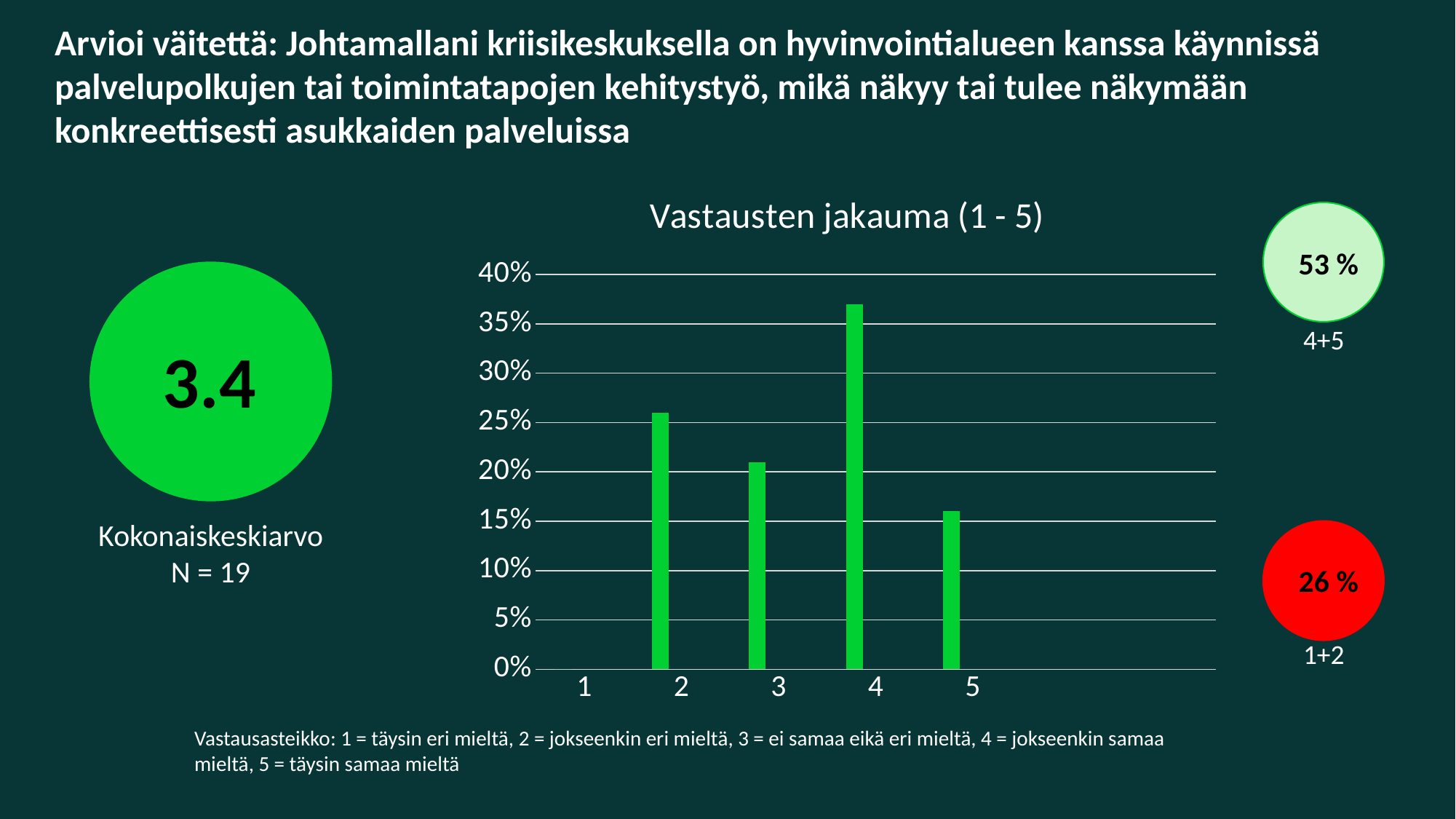
What is the title of the chart? Vastausten jakauma (1 - 5) Is the value for category 4 greater or less than 35%? greater Is the value for category 5 greater or less than 20%? less Which category has the highest value in the chart? 4 How many categories are shown on the x axis of the chart? 5 Which has the larger value, category 3 or category 5? 3 Which has the larger value, category 2 or category 3? 2 Which has the larger value, category 5 or category 4? 4 Is the value for category 3 greater or less than 25%? less What kind of chart is shown on the slide? bar chart Which category has the lowest value in the chart? 1